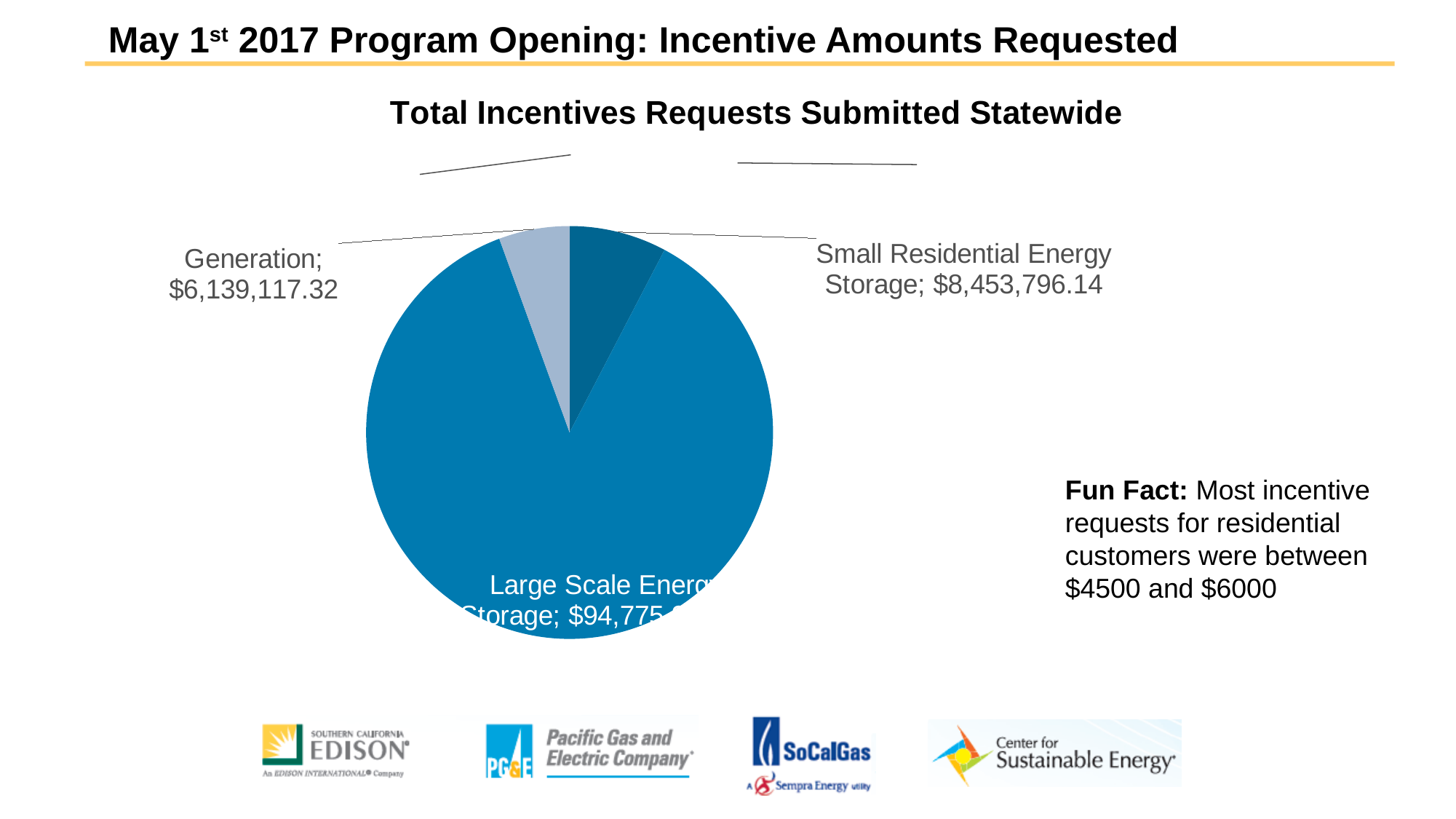
What kind of chart is shown on the slide? pie chart Which category has the smallest slice of the pie? Generation Which category is shown as the light grey-blue slice of the pie? Generation Which is larger, the amount for Large Scale Energy Storage or the amount for Small Residential Energy Storage? Large Scale Energy Storage What is the difference between the Small Residential Energy Storage amount and the Generation amount? $2,314,678.82 What is the incentive amount requested for Generation? $6,139,117.32 How many slices does the pie chart have? 3 Which is larger, the amount for Generation or the amount for Small Residential Energy Storage? Small Residential Energy Storage Which category has the largest slice of the pie? Large Scale Energy Storage What is the title of the pie chart? Total Incentives Requests Submitted Statewide What is the incentive amount requested for Small Residential Energy Storage? $8,453,796.14